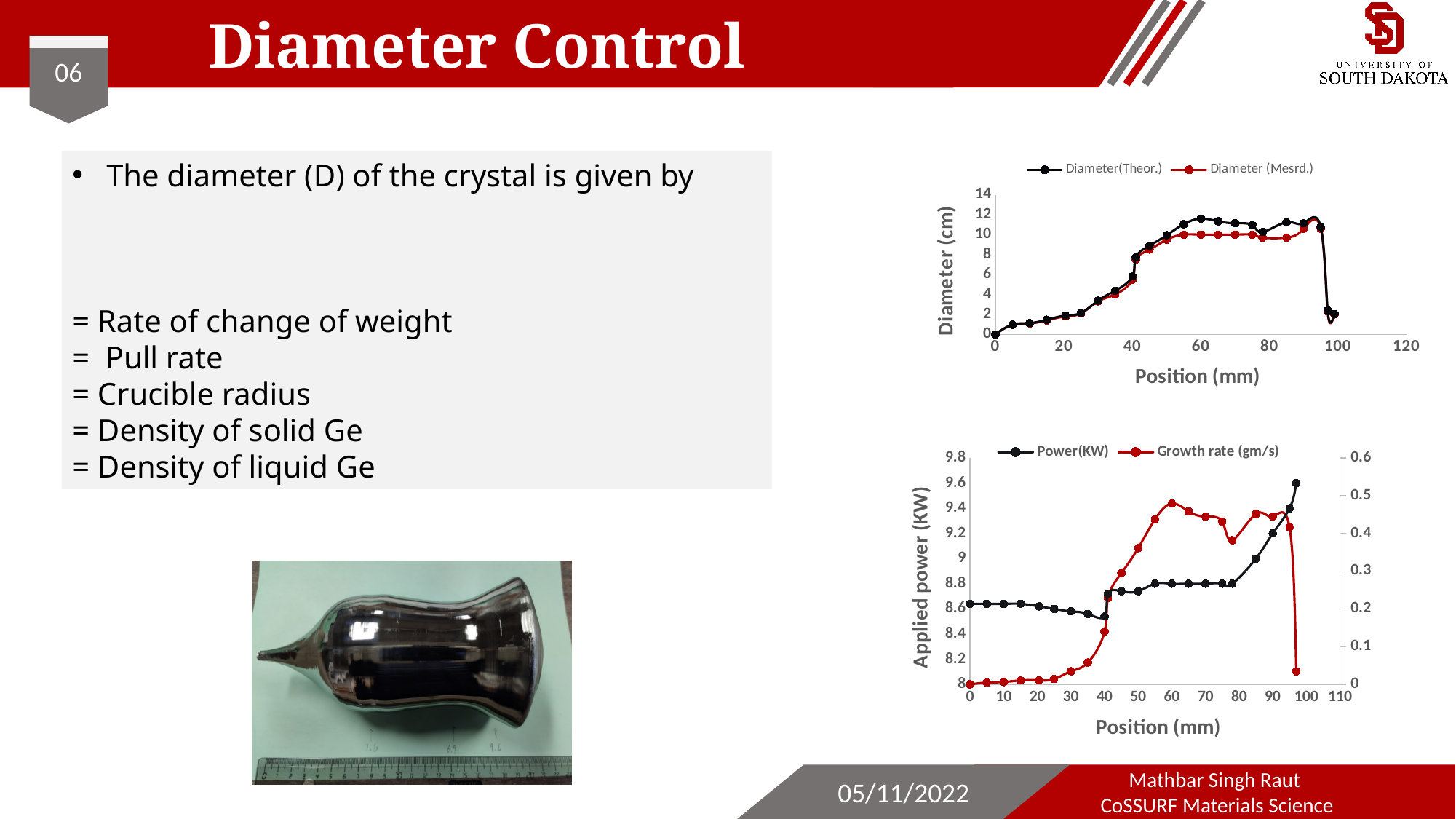
What type of chart is the top chart on the slide (Diameter vs Position)? line chart In the bottom chart (Applied power vs Position), which series is plotted in red? Growth rate (gm/s) In the bottom chart (Applied power vs Position), does the Power(KW) series rise or fall as position increases from 40 to 97 mm? rise How many series does the legend of the top chart (Diameter vs Position) list? 2 In the bottom chart (Applied power vs Position), is the Power(KW) value at position 0 mm greater or less than 8.4? greater In the top chart (Diameter vs Position), is the Diameter(Theor.) value at position 60 mm greater or less than 10? greater How many series does the legend of the bottom chart (Applied power vs Position) list? 2 In the top chart (Diameter vs Position), which series has the larger value at position 60 mm, Diameter(Theor.) or Diameter (Mesrd.)? Diameter(Theor.) In the top chart (Diameter vs Position), does the diameter rise or fall as position increases from 0 to 60 mm? rise What is the y-axis label of the top chart on the slide? Diameter (cm) In the bottom chart (Applied power vs Position), is the Growth rate (gm/s) value at position 60 mm greater or less than 0.4? greater